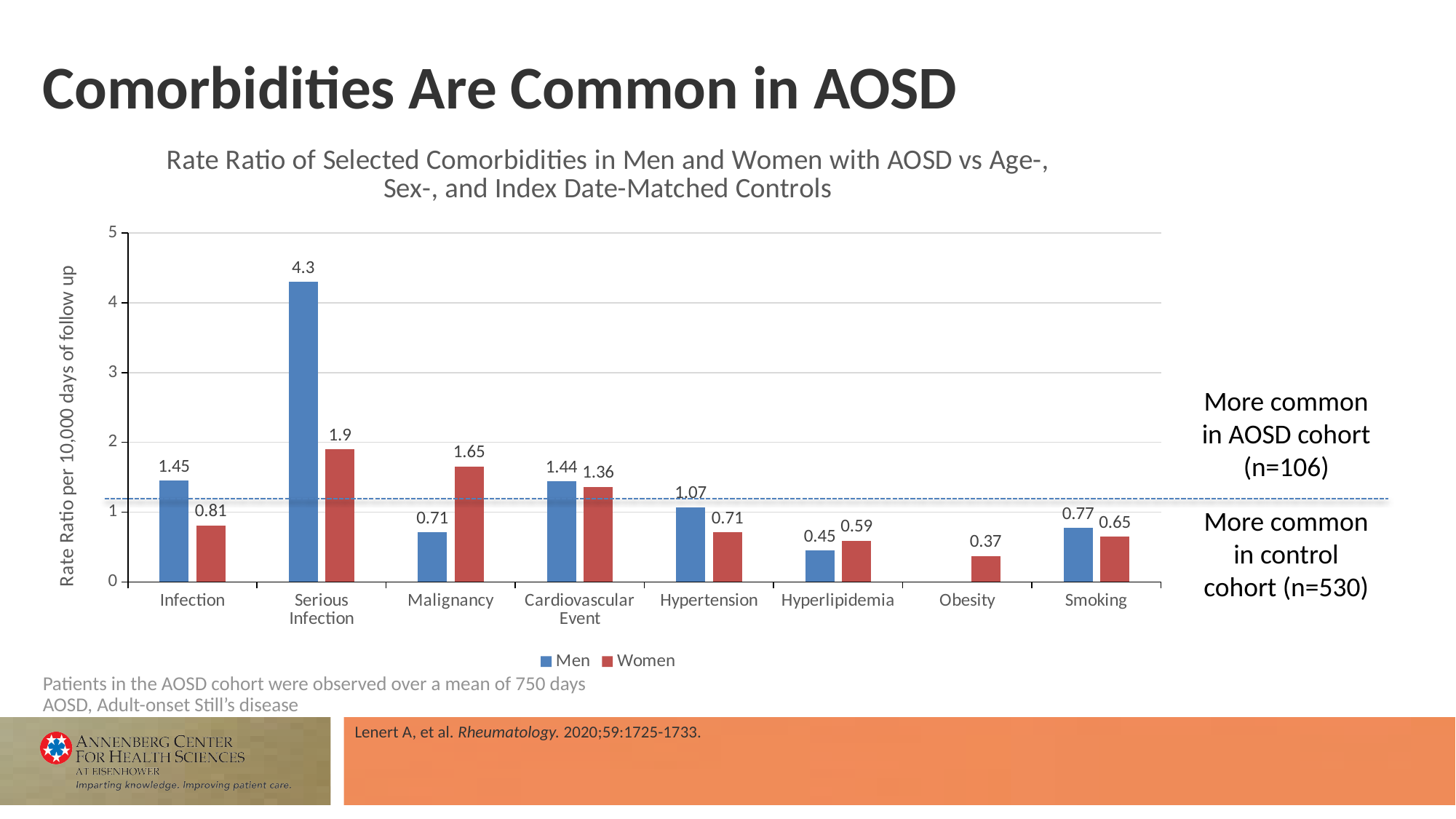
What is the difference between the Men and Women rate ratios for Serious Infection? 2.4 For Hyperlipidemia, which is larger: the rate ratio for Men or for Women? Women What kind of chart is shown on the slide? Bar chart What is the rate ratio for Women for Obesity? 0.37 What is the rate ratio for Men for Serious Infection? 4.3 Which comorbidity has the highest rate ratio for Men? Serious Infection How many comorbidity categories are shown on the x axis? 8 What is the rate ratio for Women for Malignancy? 1.65 How many series does the legend list? 2 What is the difference between the Women and Men rate ratios for Malignancy? 0.94 What is the rate ratio for Men for Hypertension? 1.07 Which comorbidity has the lowest rate ratio for Women? Obesity